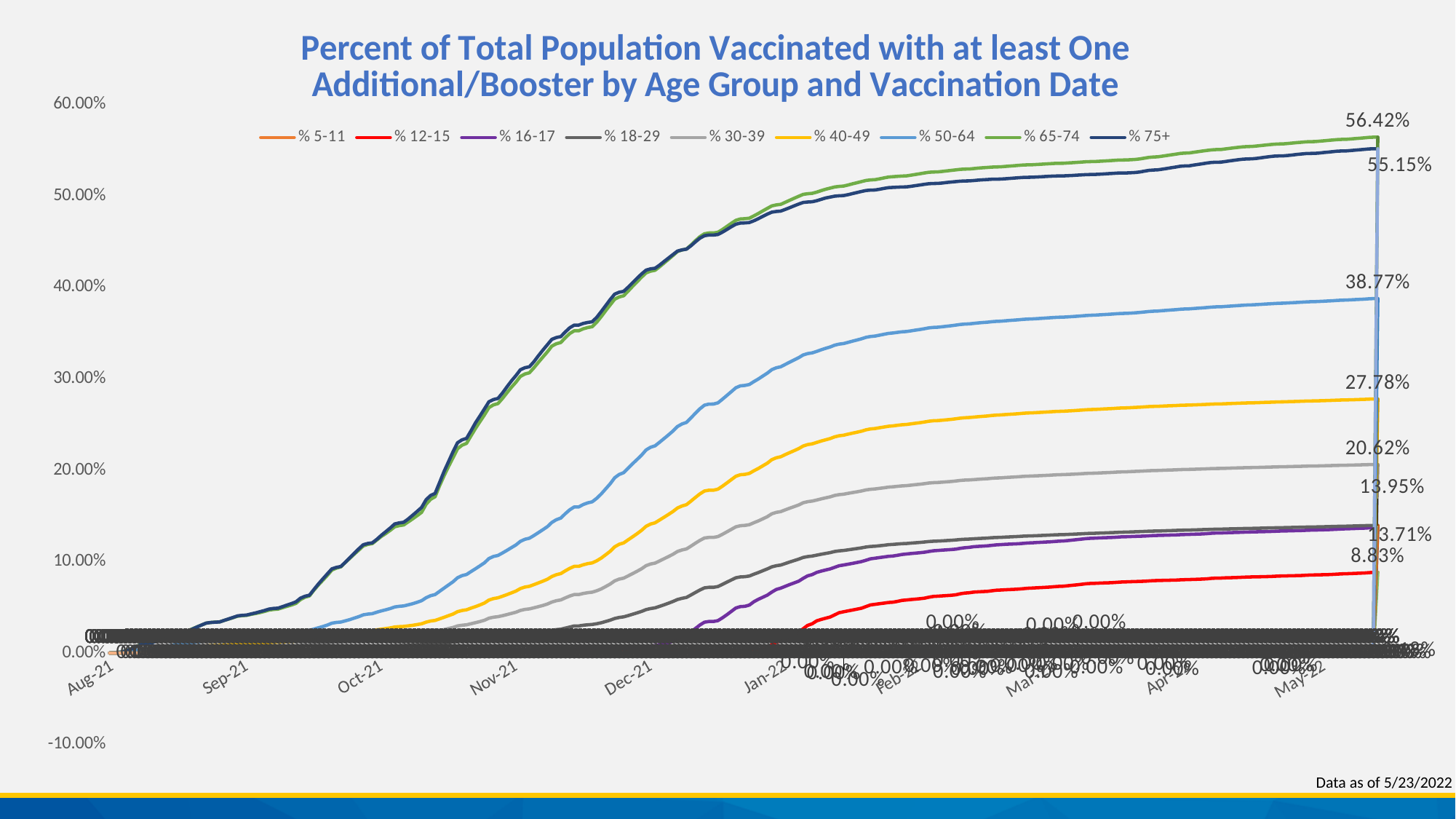
How many series does the legend list? 9 Which age group has the highest value at the end of the chart? % 65-74 What kind of chart is shown on the slide? line chart What is the final labelled value for the % 50-64 series? 38.77% Is the final value for the % 50-64 series greater or less than 30.00%? greater Do the values for the % 65-74 series rise or fall from Aug-21 to May-22? rise What is the final labelled value for the % 40-49 series? 27.78% What is the final labelled value for the % 65-74 series? 56.42% What is the final labelled value for the % 75+ series? 55.15% What is the difference between the final values of the % 65-74 and % 75+ series? 1.27% Which has a higher final value, the % 40-49 series or the % 30-39 series? % 40-49 What is the final labelled value for the % 12-15 series? 8.83%